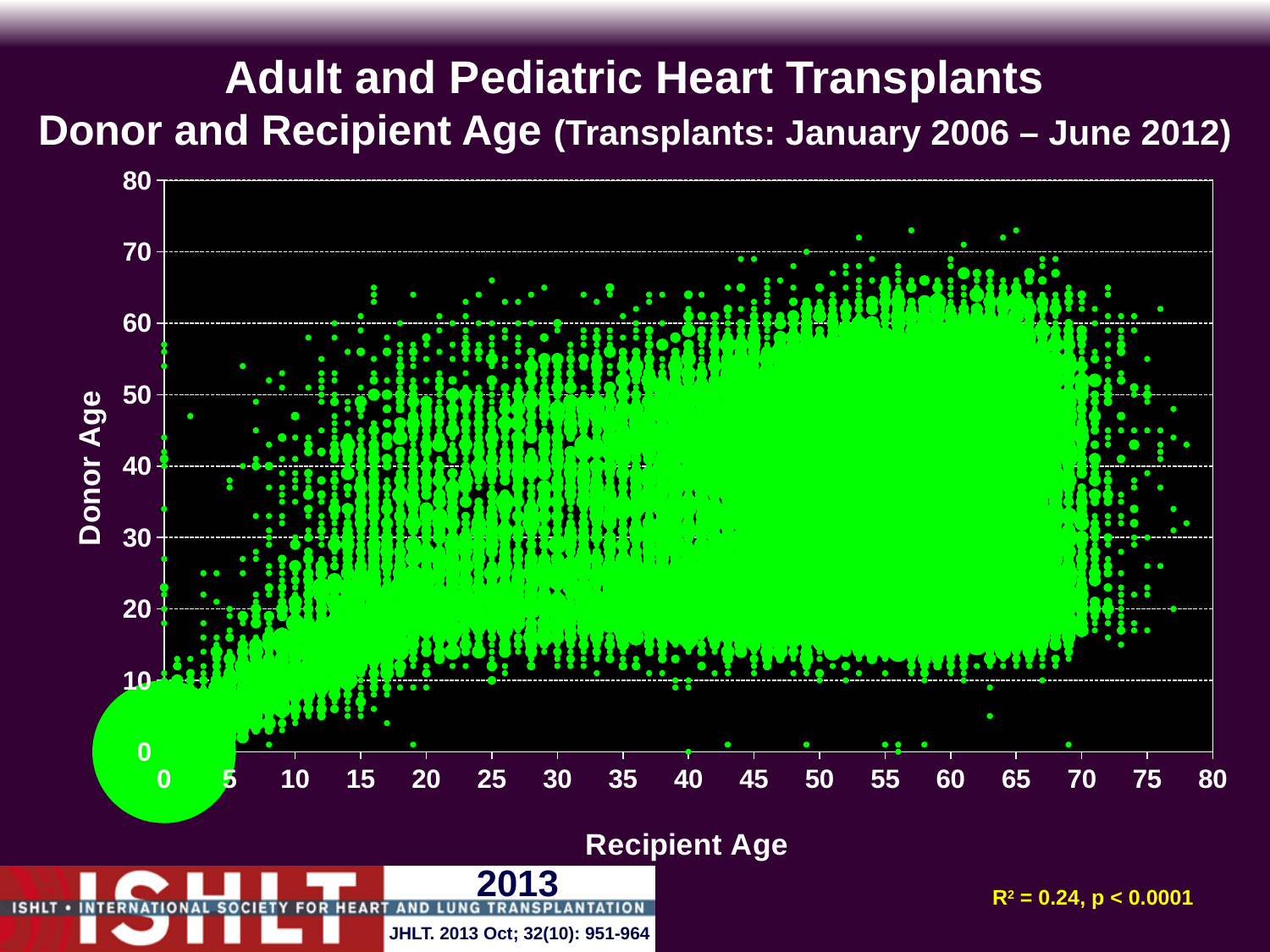
What R² value is printed on the slide? 0.24 What is the highest value shown on the y axis? 80 What kind of chart is shown on the slide? bubble chart What is the highest value shown on the x axis? 80 Does donor age generally rise or fall as recipient age increases along the x axis? rise What is the title of the y axis? Donor Age What p-value is printed on the slide? p < 0.0001 What is the title of the x axis? Recipient Age